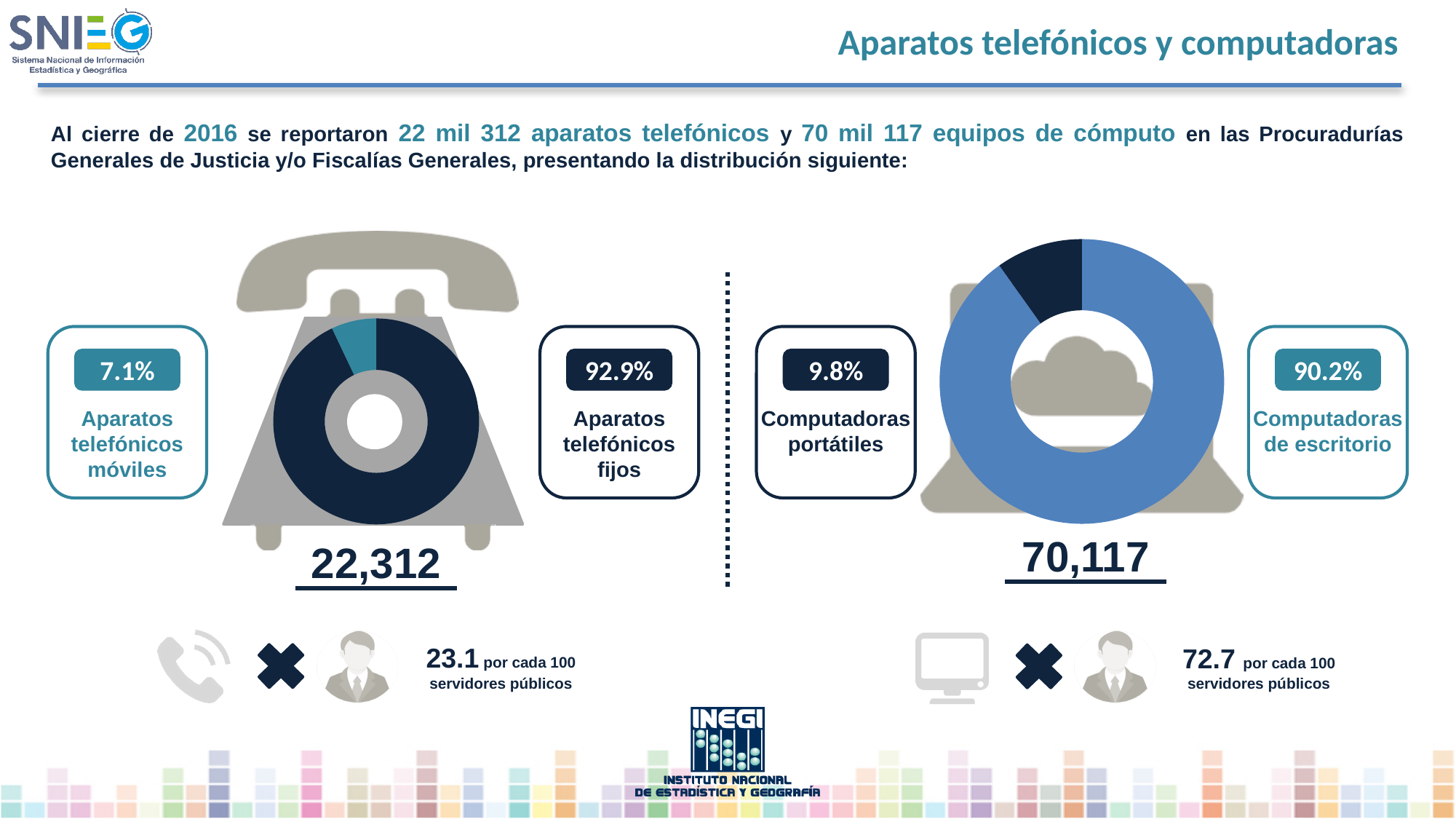
What total number of equipos de cómputo is printed below the right chart? 70,117 On the right chart (computadoras), what share is shown for Computadoras portátiles? 9.8% Which is larger: the share of Aparatos telefónicos móviles on the left chart or the share of Computadoras portátiles on the right chart? Computadoras portátiles On the right chart (computadoras), which category has the smallest share? Computadoras portátiles On the right chart (computadoras), what share is shown for Computadoras de escritorio? 90.2% How many categories does the right chart (computadoras) show? 2 On the left chart (aparatos telefónicos), what is the difference in percentage points between Aparatos telefónicos fijos and Aparatos telefónicos móviles? 85.8 percentage points On the left chart (aparatos telefónicos), what share is shown for Aparatos telefónicos móviles? 7.1% On the right chart (computadoras), what is the difference in percentage points between Computadoras de escritorio and Computadoras portátiles? 80.4 percentage points On the left chart (aparatos telefónicos), what share is shown for Aparatos telefónicos fijos? 92.9% On the left chart (aparatos telefónicos), which category has the largest share? Aparatos telefónicos fijos What kind of chart is used on the left to show the distribution of aparatos telefónicos? Donut chart